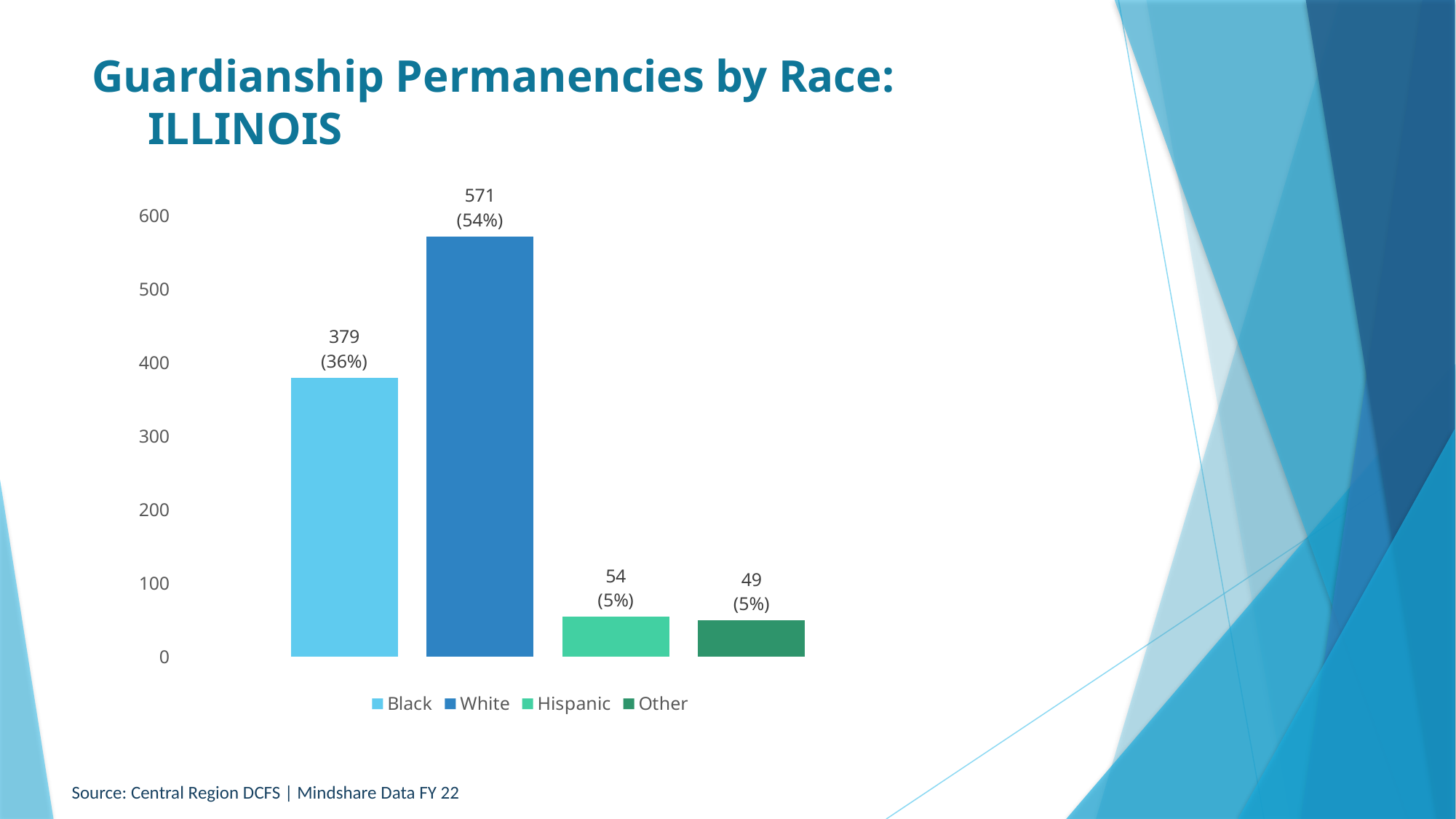
Which category has the lowest value? Other How many categories are shown in the chart? 4 What is the value for White? 571 What is the value for Hispanic? 54 What is the value for Black? 379 Is the value for Black greater or less than 400? less What kind of chart is shown on the slide? bar chart What percentage is shown for Other? 5% Which category has the highest value? White Which is larger, the value for Hispanic or the value for Other? Hispanic What is the difference between the values for White and Black? 192 What is the source cited at the bottom of the slide? Central Region DCFS | Mindshare Data FY 22